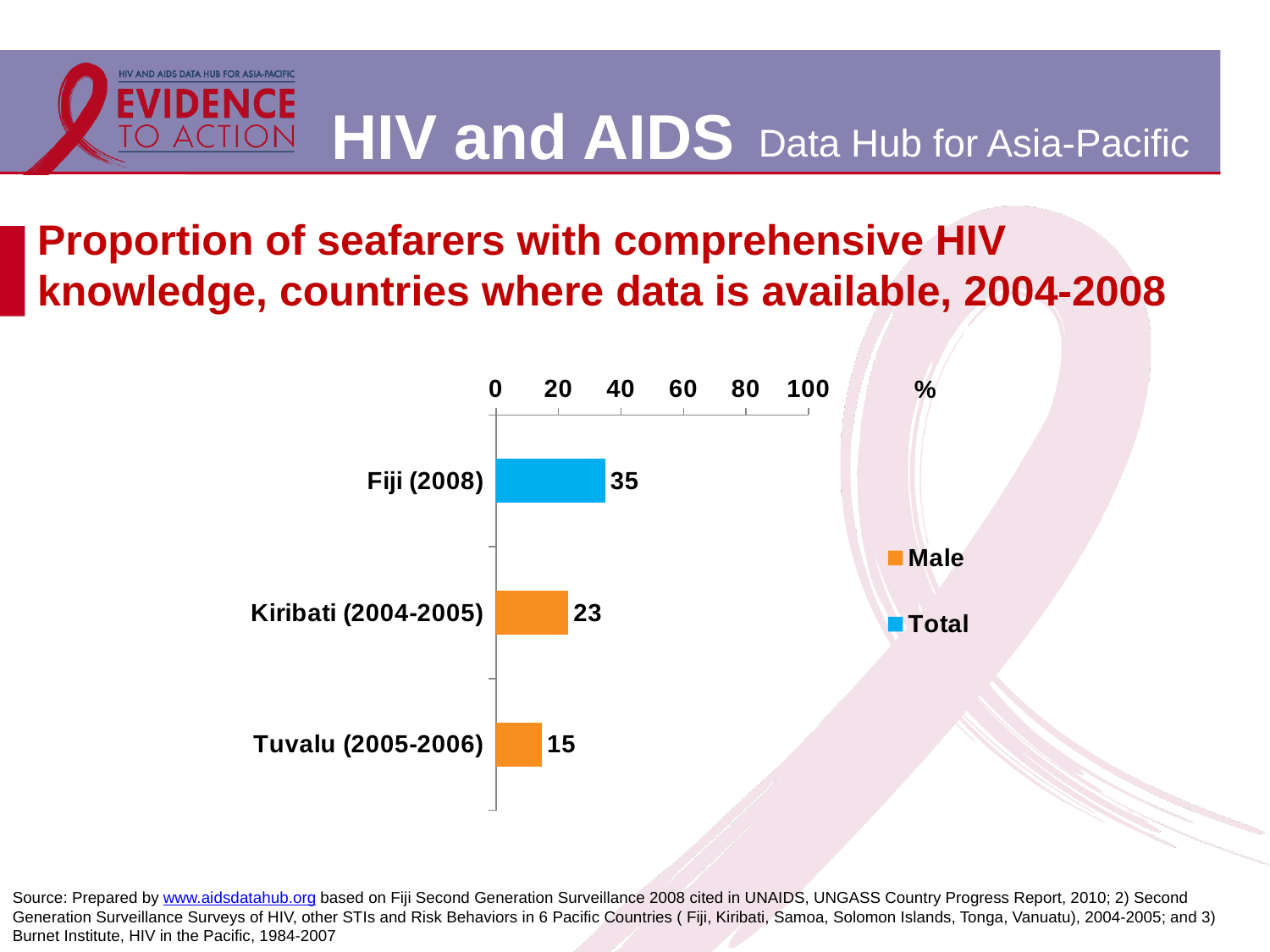
What is the value for Kiribati (2004-2005)? 23 Which country has the highest proportion of seafarers with comprehensive HIV knowledge? Fiji (2008) What is the value for Fiji (2008)? 35 What is the value for Tuvalu (2005-2006)? 15 Which is larger, the value for Kiribati (2004-2005) or the value for Tuvalu (2005-2006)? Kiribati (2004-2005) What is the difference between the values for Fiji (2008) and Tuvalu (2005-2006)? 20 What kind of chart is shown on the slide? bar chart Is the value for Fiji (2008) greater or less than 40? less What is the difference between the values for Kiribati (2004-2005) and Tuvalu (2005-2006)? 8 How many series does the legend list? 2 Which country has the lowest proportion of seafarers with comprehensive HIV knowledge? Tuvalu (2005-2006) How many countries are shown in the chart? 3